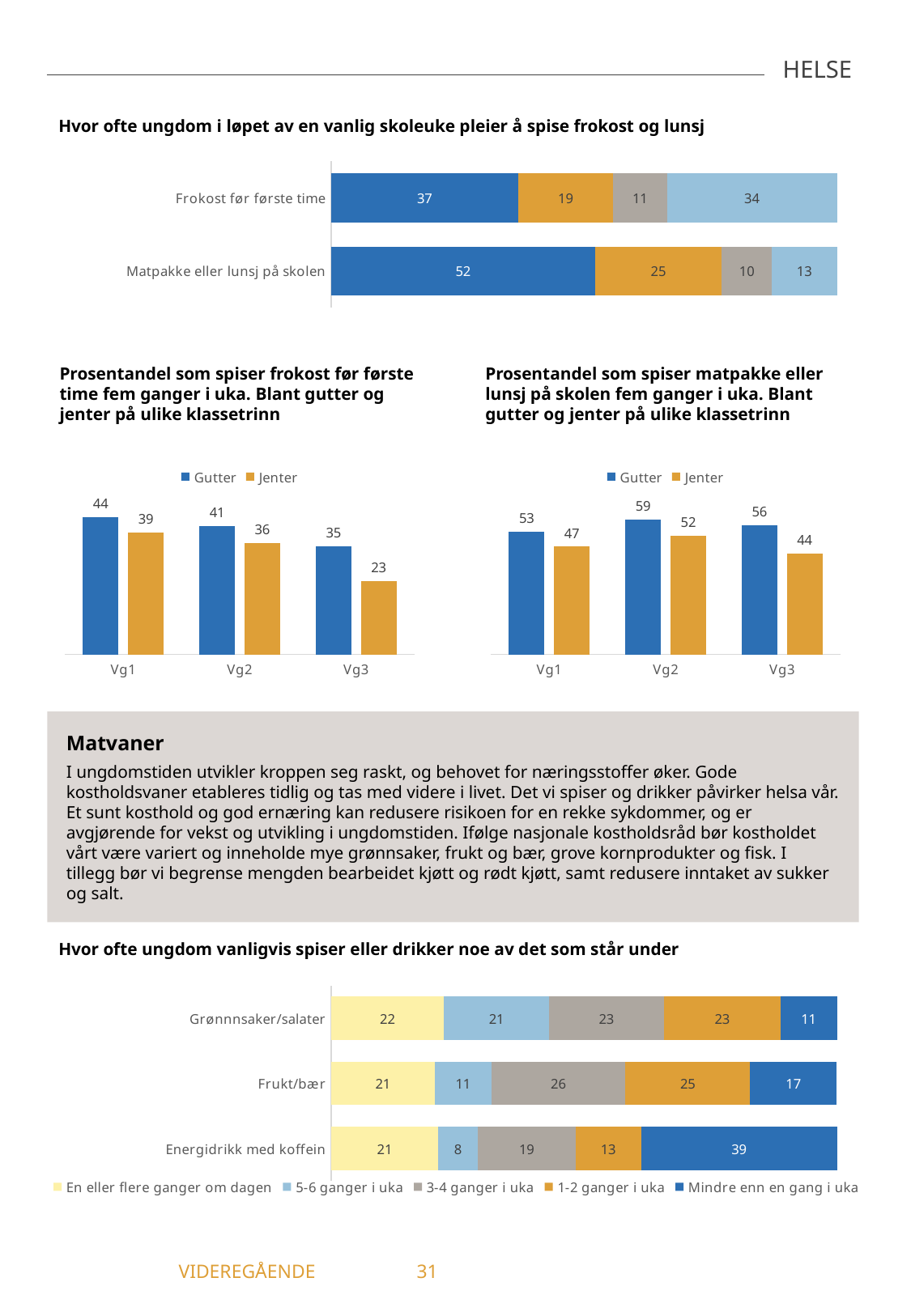
In the chart 'Prosentandel som spiser matpakke eller lunsj på skolen fem ganger i uka', what is the value for Gutter at Vg2? 59 In the chart 'Hvor ofte ungdom vanligvis spiser eller drikker noe av det som står under', what is the value for 'Mindre enn en gang i uka' for Energidrikk med koffein? 39 In the chart 'Prosentandel som spiser frokost før første time fem ganger i uka', do the Jenter values rise or fall from Vg1 to Vg3? fall In the chart 'Hvor ofte ungdom vanligvis spiser eller drikker noe av det som står under', how many series does the legend list? 5 What kind of chart is 'Hvor ofte ungdom i løpet av en vanlig skoleuke pleier å spise frokost og lunsj'? stacked bar chart In the chart 'Prosentandel som spiser frokost før første time fem ganger i uka', which class level has the highest value for Gutter? Vg1 In the chart 'Hvor ofte ungdom i løpet av en vanlig skoleuke pleier å spise frokost og lunsj', what is the value of the first (dark blue) segment for Matpakke eller lunsj på skolen? 52 In the chart 'Prosentandel som spiser matpakke eller lunsj på skolen fem ganger i uka', which class level has the lowest value for Jenter? Vg3 In the chart 'Prosentandel som spiser frokost før første time fem ganger i uka', what is the difference between Gutter and Jenter at Vg3? 12 In the chart 'Prosentandel som spiser frokost før første time fem ganger i uka', what is the value for Jenter at Vg3? 23 In the chart 'Prosentandel som spiser matpakke eller lunsj på skolen fem ganger i uka', how many series does the legend list? 2 In the chart 'Hvor ofte ungdom vanligvis spiser eller drikker noe av det som står under', which is larger for Frukt/bær: '3-4 ganger i uka' or '1-2 ganger i uka'? 3-4 ganger i uka